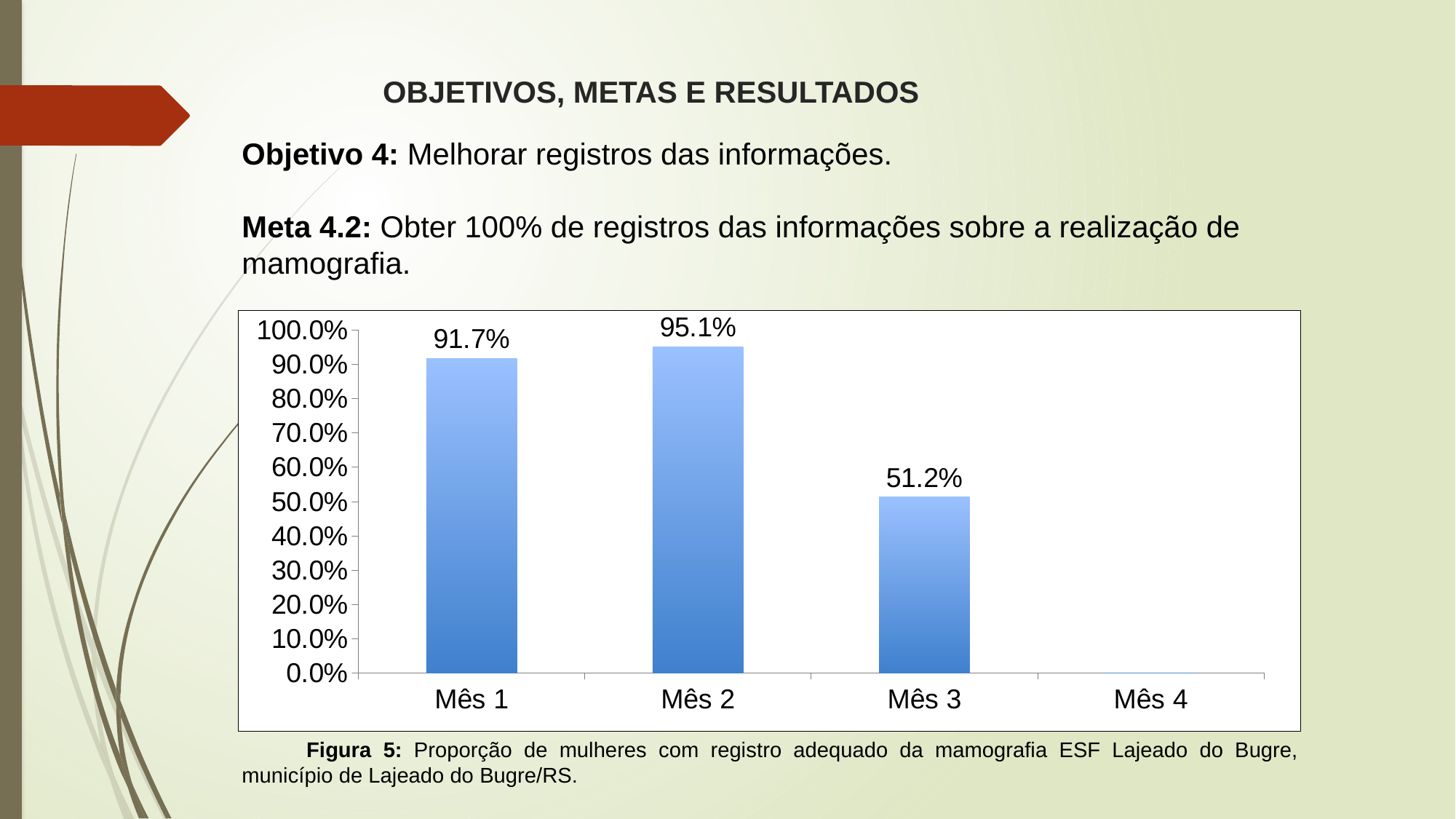
What is the difference between the values for Mês 2 and Mês 1? 3.4% Which is larger, the value for Mês 1 or the value for Mês 3? Mês 1 What is the value for Mês 3? 51.2% Does the value rise or fall from Mês 2 to Mês 3? fall What is the value for Mês 1? 91.7% Which month has the highest value? Mês 2 What is the value for Mês 2? 95.1% How many months are shown on the x axis? 4 Is the value for Mês 3 greater or less than 60.0%? less What kind of chart is shown on the slide? bar chart What is the difference between the values for Mês 2 and Mês 3? 43.9% What figure number is given in the caption below the chart? Figura 5